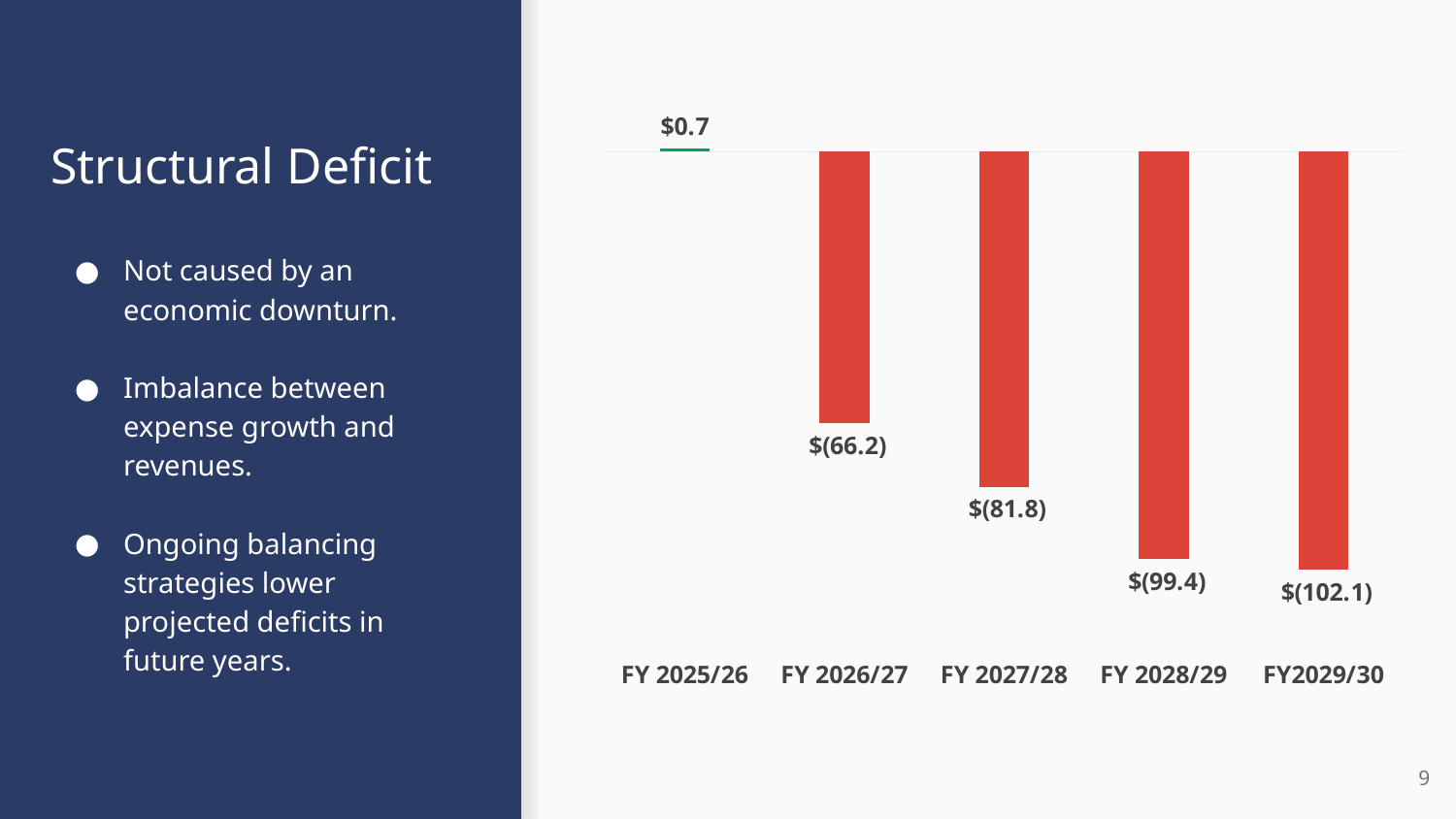
What kind of chart is shown on the slide? Bar chart Which has the larger deficit, FY 2027/28 or FY 2028/29? FY 2028/29 Do the values rise or fall from FY 2025/26 to FY2029/30? Fall Which fiscal year is the only one with a positive value? FY 2025/26 What is the difference between the FY 2028/29 and FY2029/30 values? 2.7 What is the value shown for FY 2026/27? $(66.2) Which fiscal year shows the largest deficit (the lowest value)? FY2029/30 What is the value shown for FY 2028/29? $(99.4) What is the value shown for FY2029/30? $(102.1) How many fiscal years are shown on the x axis? 5 By how much does the deficit grow from FY 2026/27 to FY 2027/28? 15.6 What is the value shown for FY 2025/26? $0.7